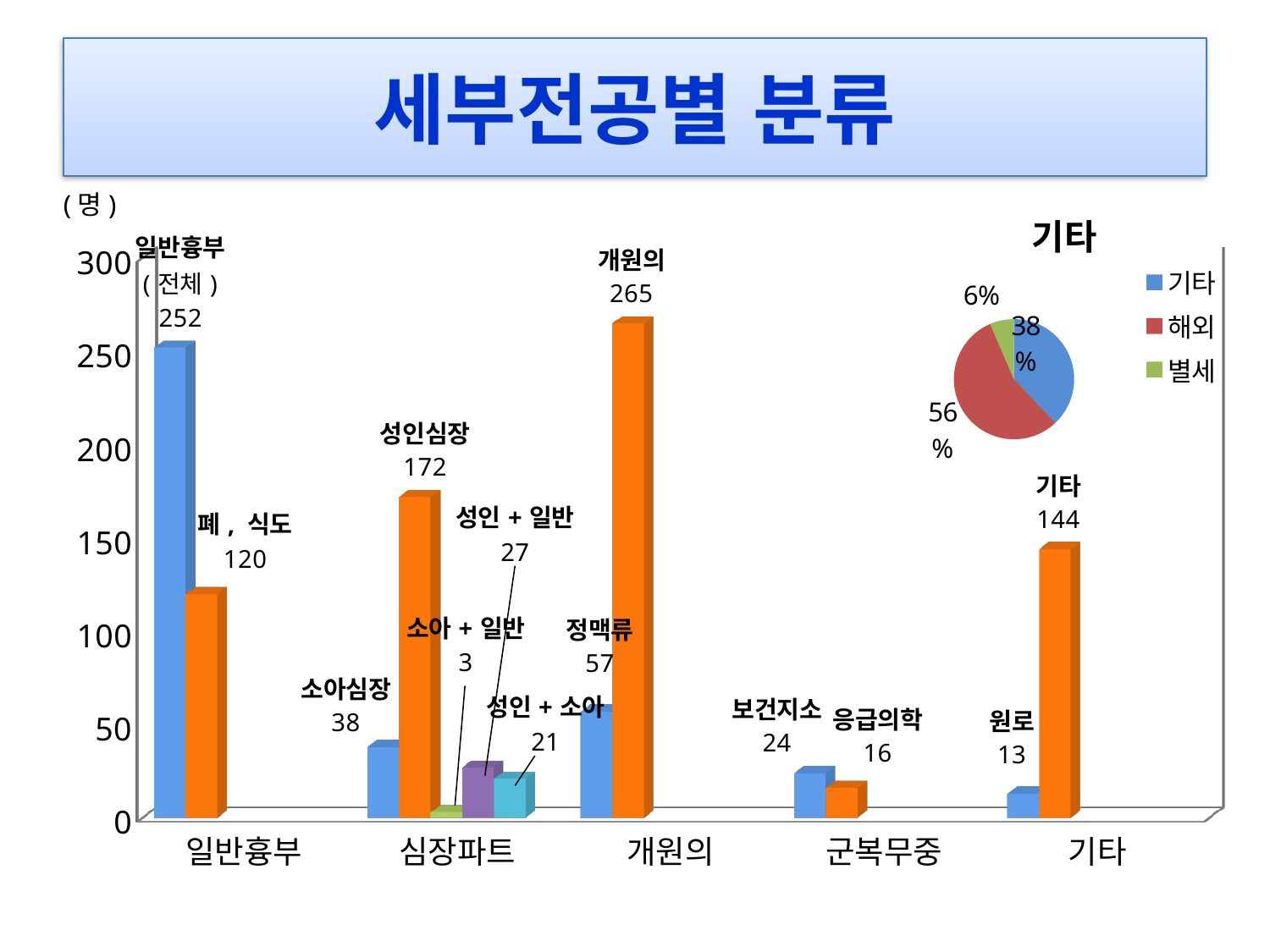
In the pie chart titled 기타, how many entries does the legend list? 3 In the bar chart, how many categories are shown on the x axis? 5 In the bar chart, which labelled bar has the highest value? 개원의 In the bar chart, what is the value labelled 폐, 식도? 120 In the bar chart, what is the value labelled 성인심장? 172 In the bar chart, which is larger, 보건지소 or 응급의학? 보건지소 In the pie chart titled 기타, what share does 해외 have? 56% In the bar chart, what is the value labelled 개원의? 265 In the bar chart, what is the difference between 일반흉부 (전체) and 폐, 식도? 132 In the bar chart, which labelled bar has the lowest value? 소아 + 일반 In the bar chart, what is the value labelled 원로? 13 What kind of chart is the large chart on the left of the slide? bar chart